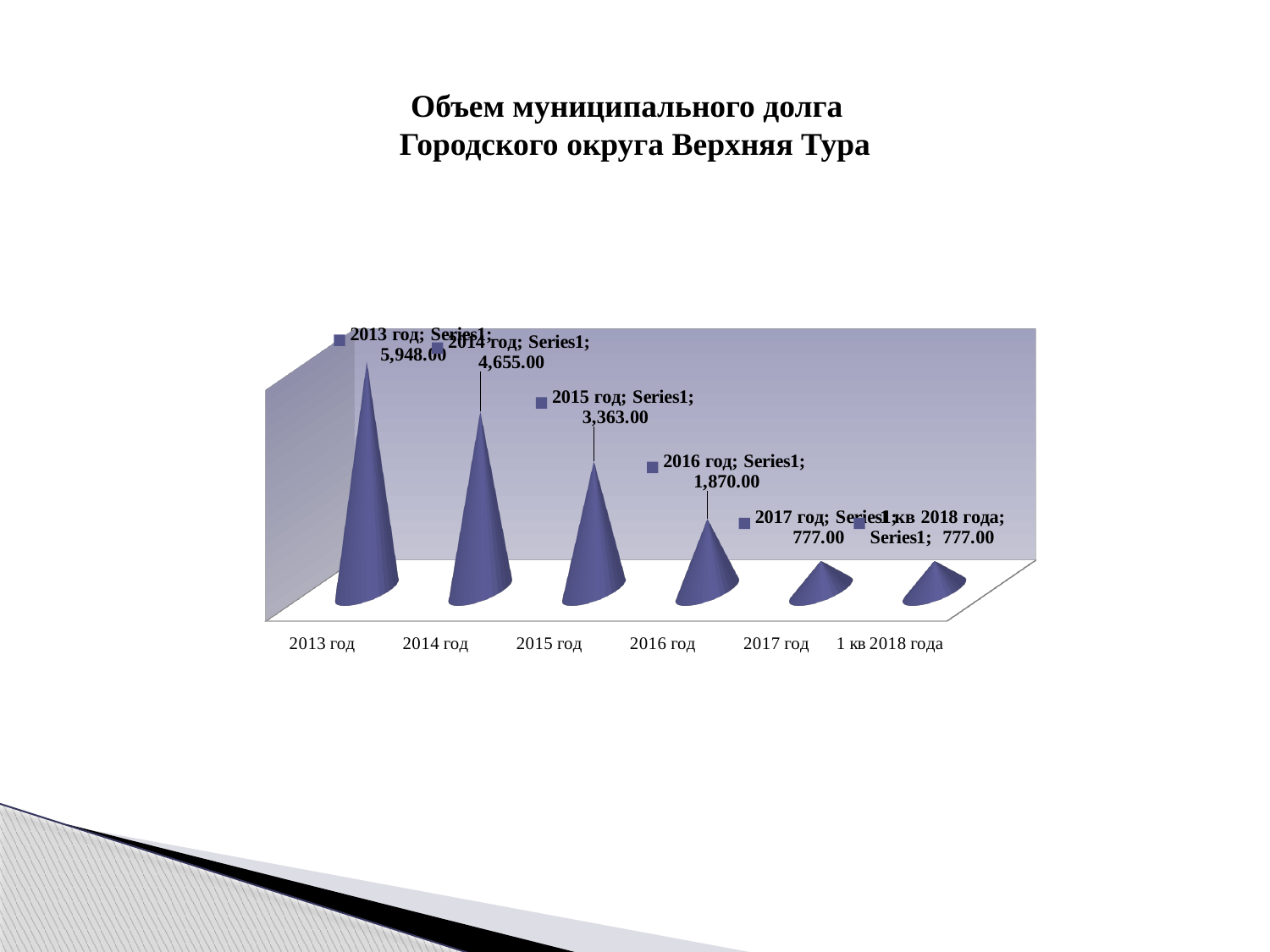
What is the value for 2015 год? 3,363.00 Do the values rise or fall from 2013 год to 2017 год? fall What is the difference between the values for 2013 год and 2014 год? 1,293.00 What is the difference between the values for 2015 год and 2016 год? 1,493.00 What kind of chart is shown on the slide? bar chart How many categories are shown on the x axis? 6 What is the title of the chart? Объем муниципального долга Городского округа Верхняя Тура What is the value for 2016 год? 1,870.00 Which is larger, the value for 2014 год or the value for 2016 год? 2014 год Which category has the highest value? 2013 год What is the value for 2013 год? 5,948.00 What is the value for 1 кв 2018 года? 777.00